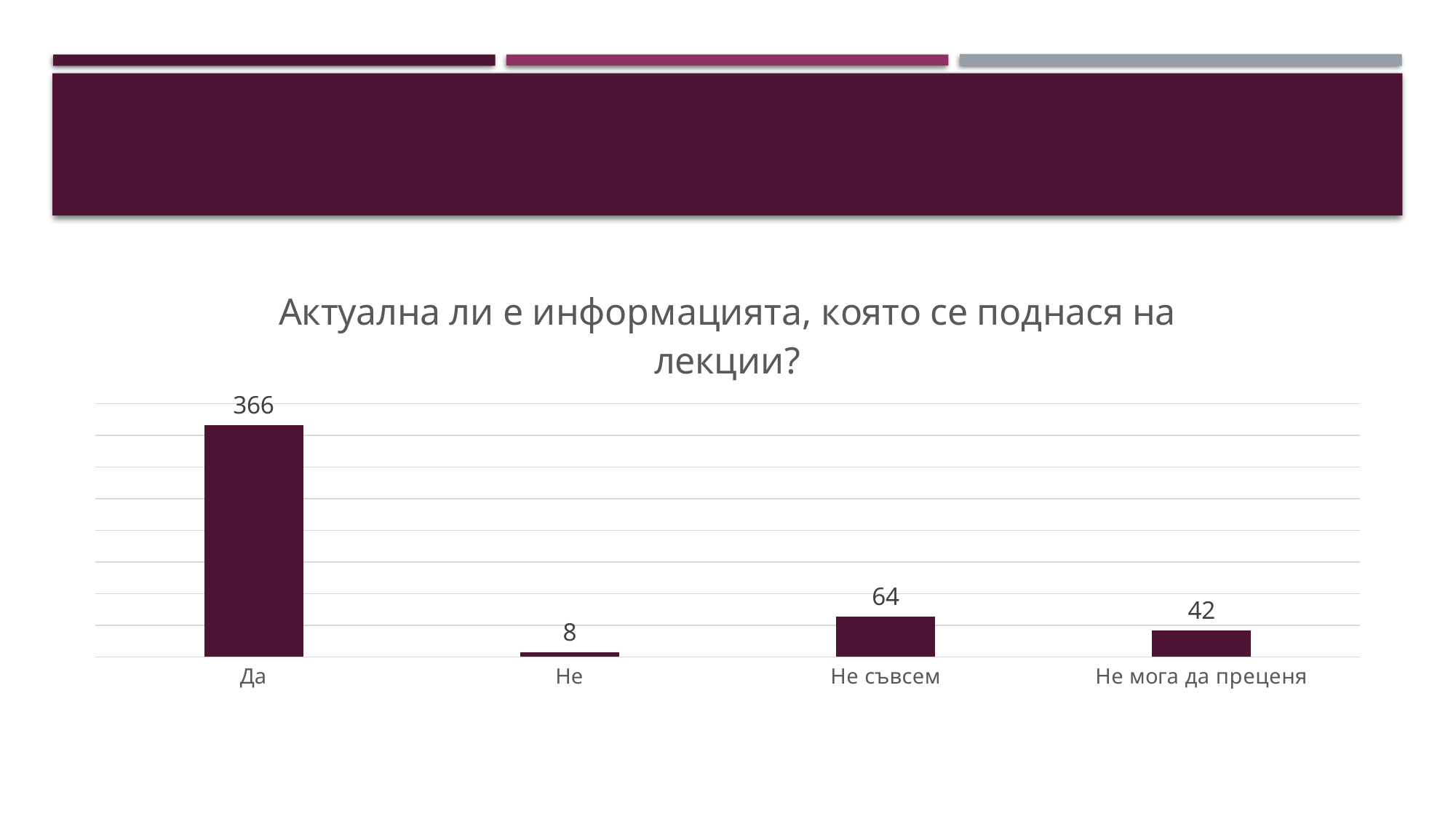
What is the value for "Не съвсем"? 64 What kind of chart is shown on the slide? bar chart How many categories are shown on the x axis? 4 What is the difference between the values for "Не съвсем" and "Не мога да преценя"? 22 What is the value for "Не"? 8 Which is larger, the value for "Не съвсем" or the value for "Не мога да преценя"? Не съвсем What is the value for "Не мога да преценя"? 42 What is the title of the chart? Актуална ли е информацията, която се поднася на лекции? Which category has the highest value? Да Which category has the lowest value? Не What is the difference between the values for "Да" and "Не съвсем"? 302 What is the value for "Да"? 366